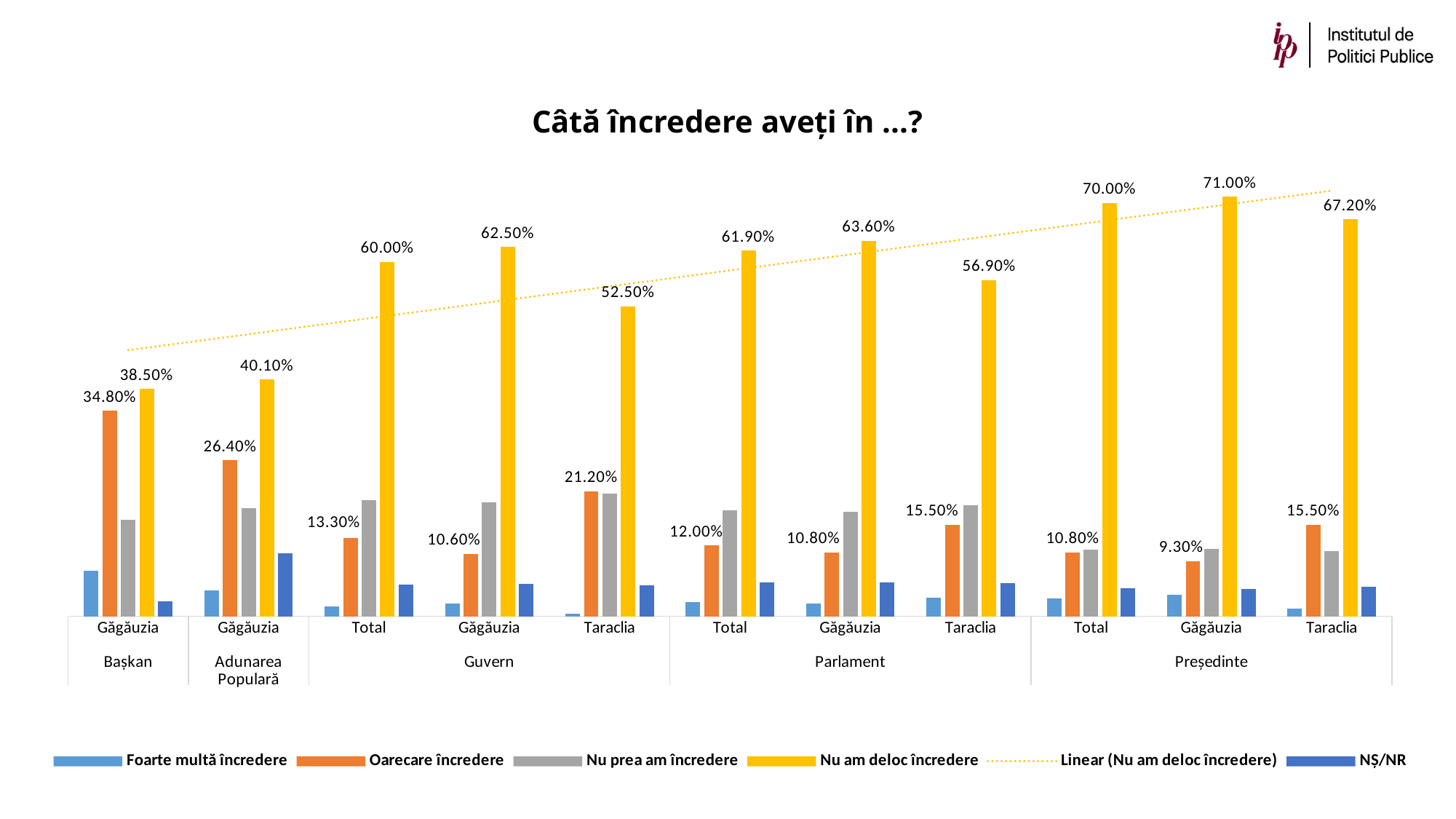
How many category groups (bar clusters) are shown on the x axis? 11 What type of chart is shown on the slide? Bar chart What is the value of "Nu am deloc încredere" for Președinte – Găgăuzia? 71.00% Which category has the lowest value for "Oarecare încredere"? Președinte – Găgăuzia What is the difference between the "Nu am deloc încredere" values for Președinte – Total and Guvern – Total? 10.00% What is the value of "Oarecare încredere" for Parlament – Total? 12.00% Which category has the lowest value for "Nu am deloc încredere"? Bașkan – Găgăuzia Which category has the highest value for "Nu am deloc încredere"? Președinte – Găgăuzia How many entries does the legend list? 6 Which is larger: "Nu am deloc încredere" for Parlament – Găgăuzia or for Parlament – Taraclia? Parlament – Găgăuzia What is the value of "Nu am deloc încredere" for Guvern – Taraclia? 52.50% What is the value of "Oarecare încredere" for Bașkan – Găgăuzia? 34.80%